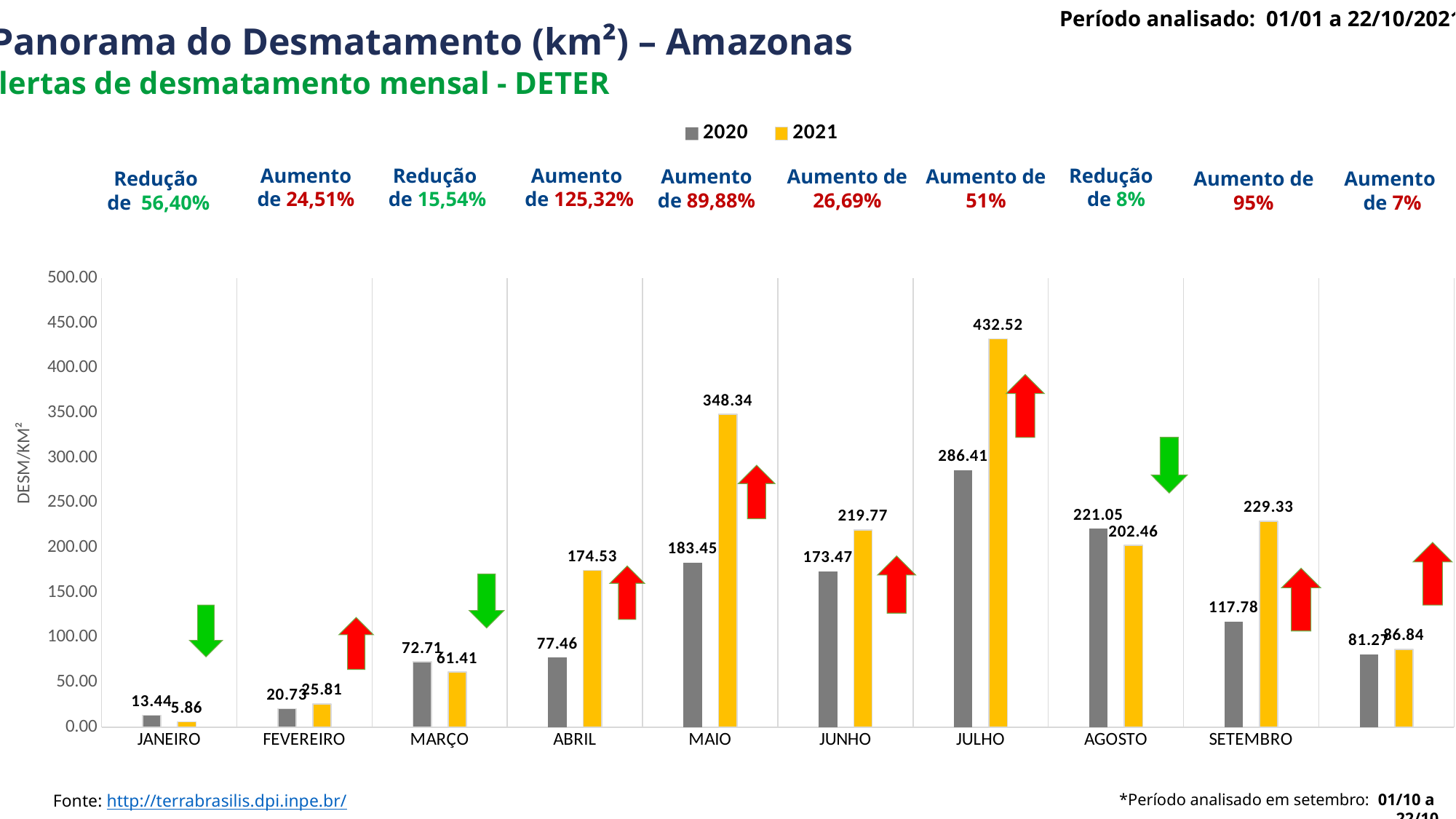
What kind of chart is shown on the slide? bar chart What is the 2021 value for JULHO? 432.52 What is the difference between the 2021 and 2020 values for JULHO? 146.11 Which month has the highest 2021 value? JULHO Is the 2021 value for MAIO greater or less than 300? greater Which month has the lowest 2021 value? JANEIRO Which month has the highest 2020 value? JULHO For AGOSTO, which series has the larger value, 2020 or 2021? 2020 What is the 2021 value for SETEMBRO? 229.33 What is the difference between the 2021 and 2020 values for MAIO? 164.89 What is the 2020 value for MAIO? 183.45 How many series does the legend list? 2